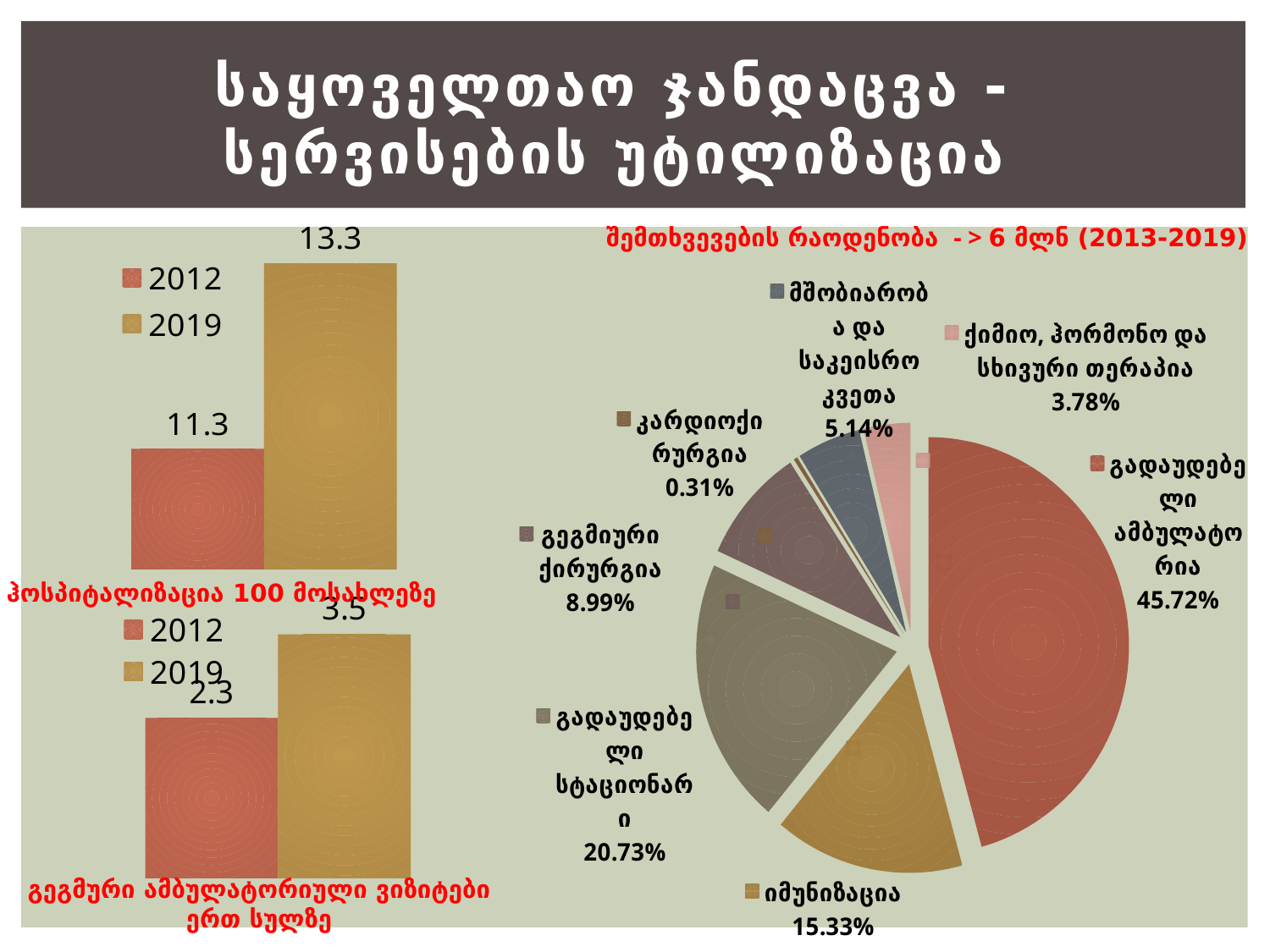
In the bottom-left bar chart (გეგმური ამბულატორიული ვიზიტები ერთ სულზე), what is the value for 2019? 3.5 In the bottom-left bar chart (გეგმური ამბულატორიული ვიზიტები ერთ სულზე), which year has the larger value, 2012 or 2019? 2019 In the pie chart on the right, what share does გადაუდებელი ამბულატორია have? 45.72% How many slices does the pie chart on the right have? 7 What kind of chart is the chart on the right side of the slide (შემთხვევების რაოდენობა)? pie chart In the top-left bar chart (ჰოსპიტალიზაცია 100 მოსახლეზე), what is the value for 2019? 13.3 In the bottom-left bar chart (გეგმური ამბულატორიული ვიზიტები ერთ სულზე), what is the value for 2012? 2.3 In the pie chart on the right, what is the share for იმუნიზაცია? 15.33% In the top-left bar chart (ჰოსპიტალიზაცია 100 მოსახლეზე), what is the difference between the 2019 and 2012 values? 2.0 In the top-left bar chart (ჰოსპიტალიზაცია 100 მოსახლეზე), what is the value for 2012? 11.3 How many series does the legend of the top-left bar chart list? 2 In the pie chart on the right, which category has the smallest share? კარდიოქირურგია